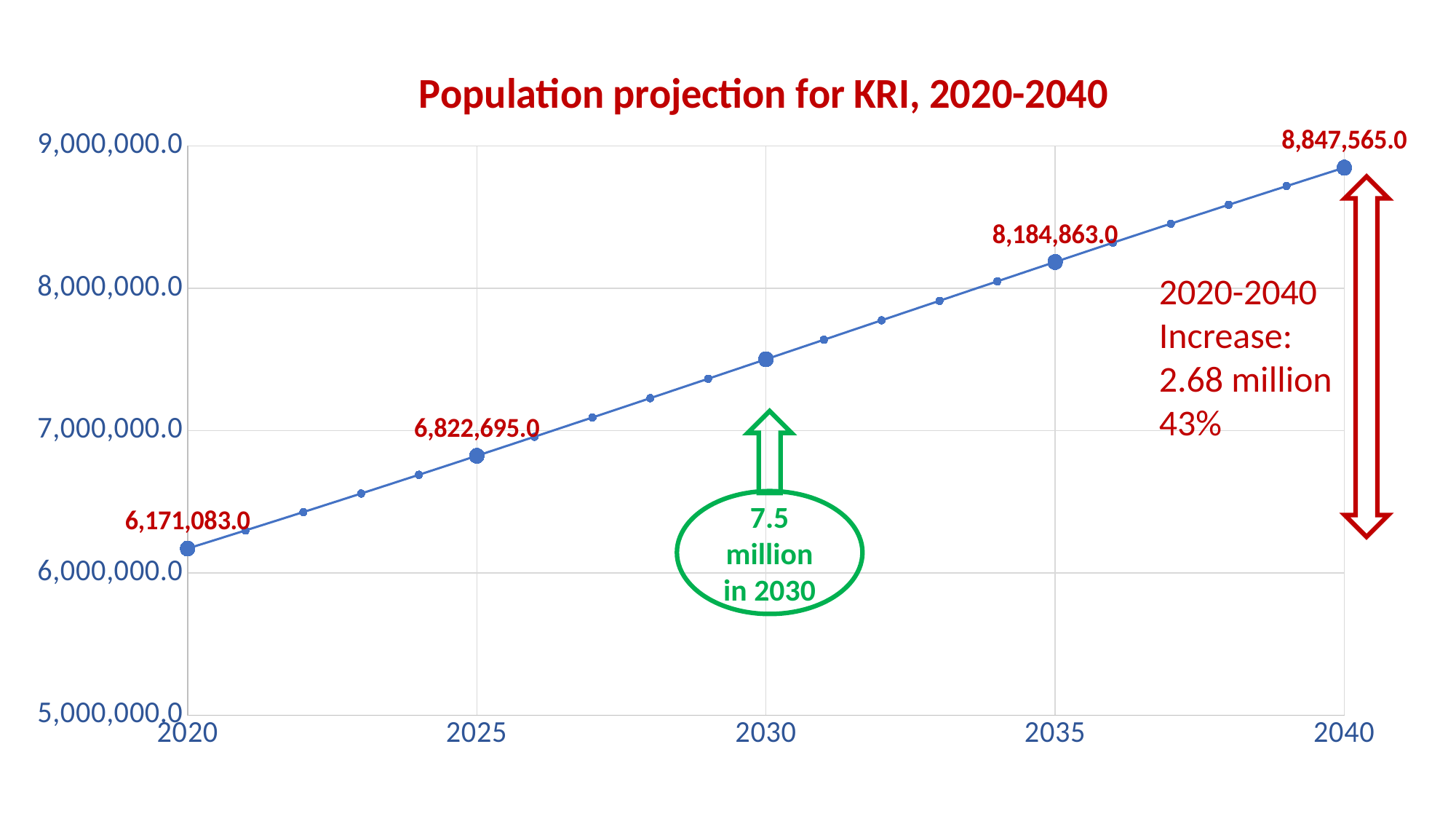
What is the difference between the projected population in 2025 and in 2020? 651,612.0 What is the projected population for KRI in 2025? 6,822,695.0 What is the difference between the projected population in 2040 and in 2020? 2,676,482.0 Which year has the lowest projected population on the chart? 2020 What is the projected population for KRI in 2020? 6,171,083.0 What kind of chart is shown on the slide? line chart Which year has the highest projected population on the chart? 2040 Does the projected population rise or fall from 2020 to 2040? rise What is the projected population for KRI in 2040? 8,847,565.0 What is the projected population for KRI in 2035? 8,184,863.0 How many data points are plotted on the line? 21 Is the projected population in 2030 greater or less than 7,000,000.0? greater